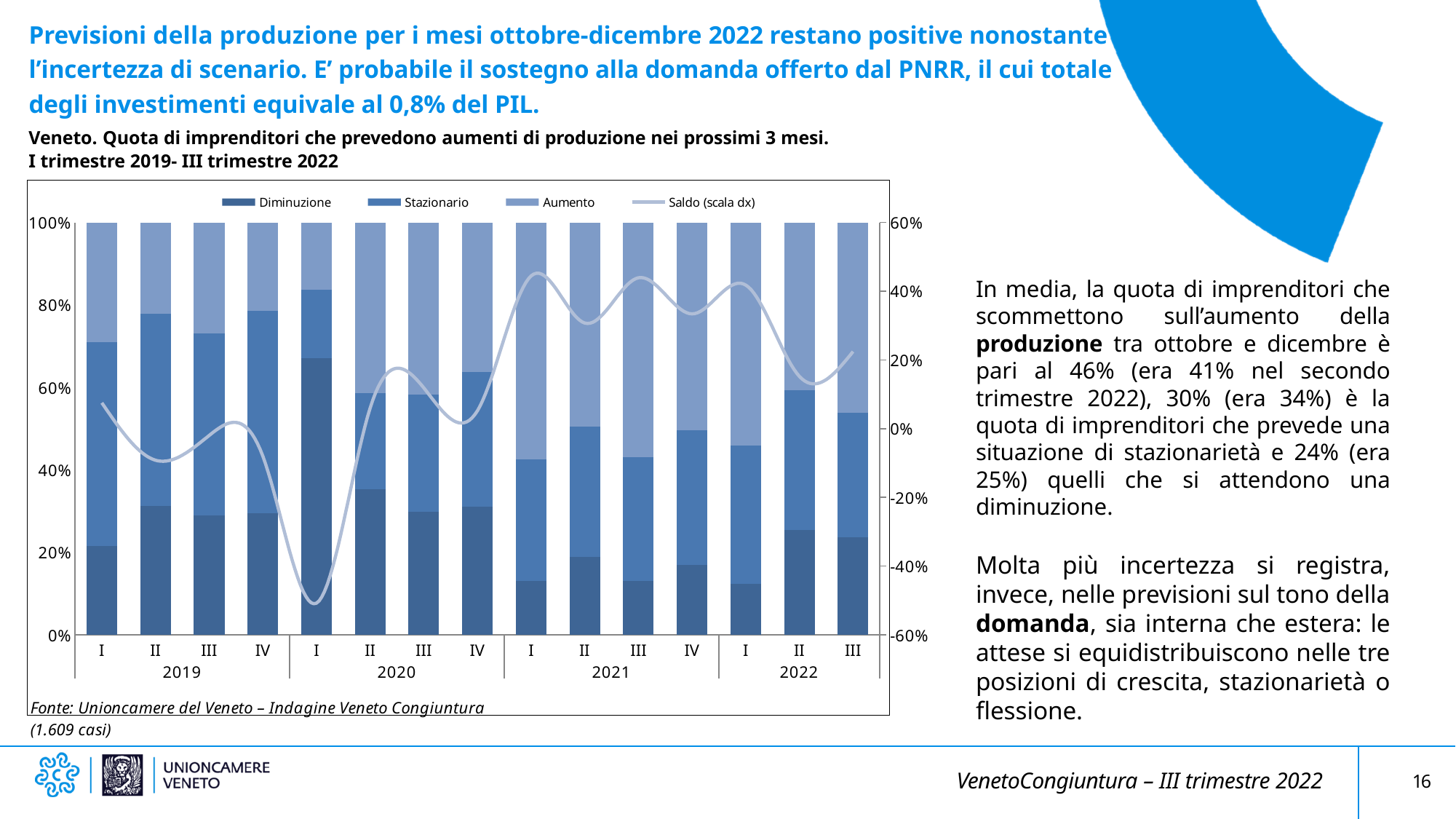
Which series is plotted as a line on the secondary (right) axis? Saldo (scala dx) What is the source cited below the chart? Unioncamere del Veneto – Indagine Veneto Congiuntura How many series does the chart legend list? 4 Is the Saldo value in I 2020 greater or less than -40%? less What kind of chart is shown on the slide? Stacked bar chart with a line Is the Diminuzione share in I 2020 greater or less than 60%? greater Is the Diminuzione share in I 2021 greater or less than 20%? less In which quarter is the Diminuzione share the highest? I 2020 How many quarterly bars are plotted in the chart? 15 In which quarter does the Saldo line reach its lowest value? I 2020 In which quarter is the Aumento share the smallest? I 2020 Does the Saldo line rise or fall from I 2020 to I 2021? rise